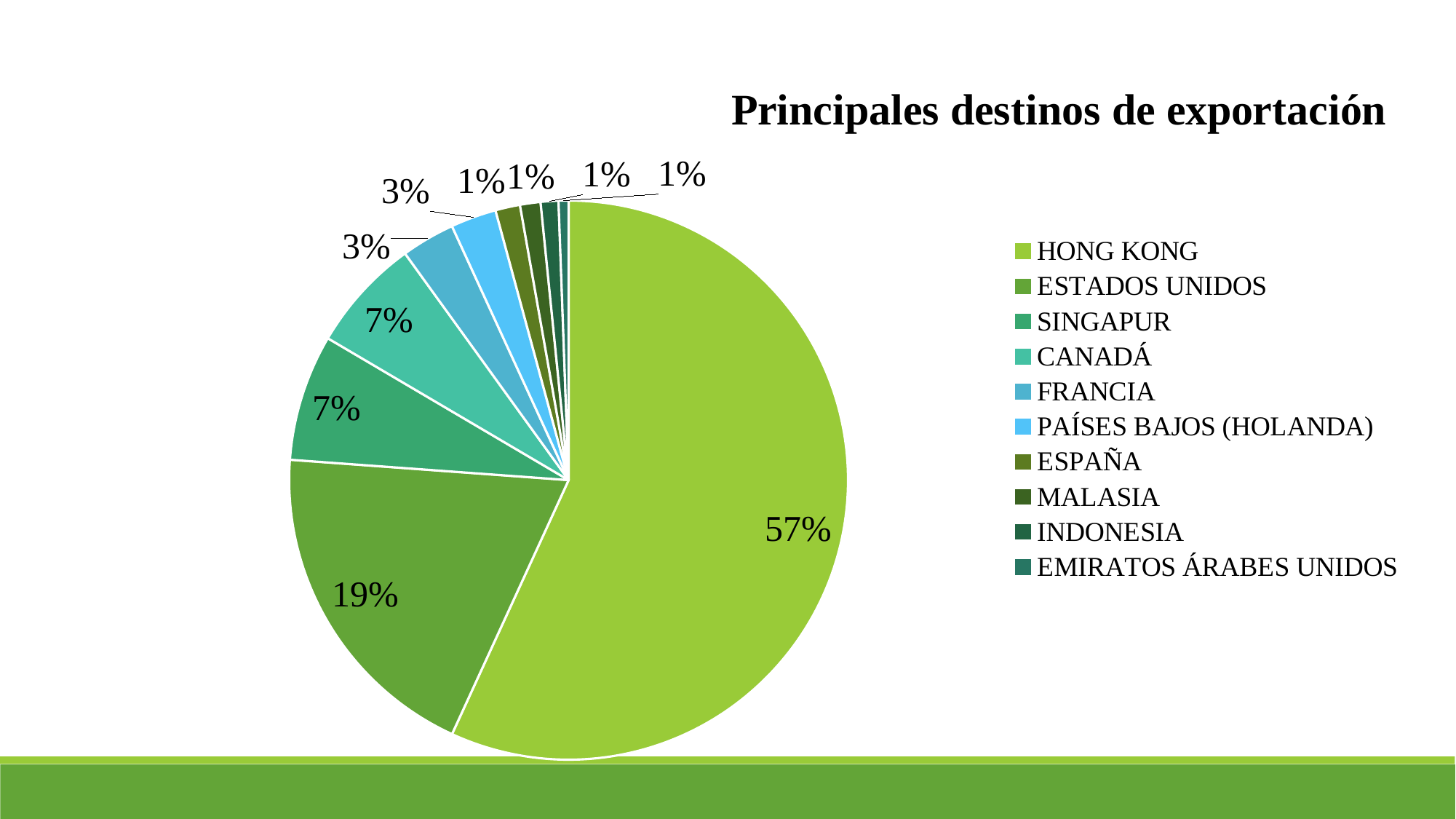
What percentage is shown for CANADÁ? 7% What is the combined share of SINGAPUR and CANADÁ? 14% Which has a larger share, SINGAPUR or PAÍSES BAJOS (HOLANDA)? SINGAPUR What share of exports goes to ESTADOS UNIDOS? 19% What percentage is shown for FRANCIA? 3% Which destination has the largest share of exports? HONG KONG What share of exports goes to HONG KONG? 57% What is the difference in percentage points between HONG KONG and ESTADOS UNIDOS? 38 What type of chart is shown on the slide? pie chart What percentage is shown for MALASIA? 1% What is the title of the chart? Principales destinos de exportación How many destinations are listed in the legend? 10